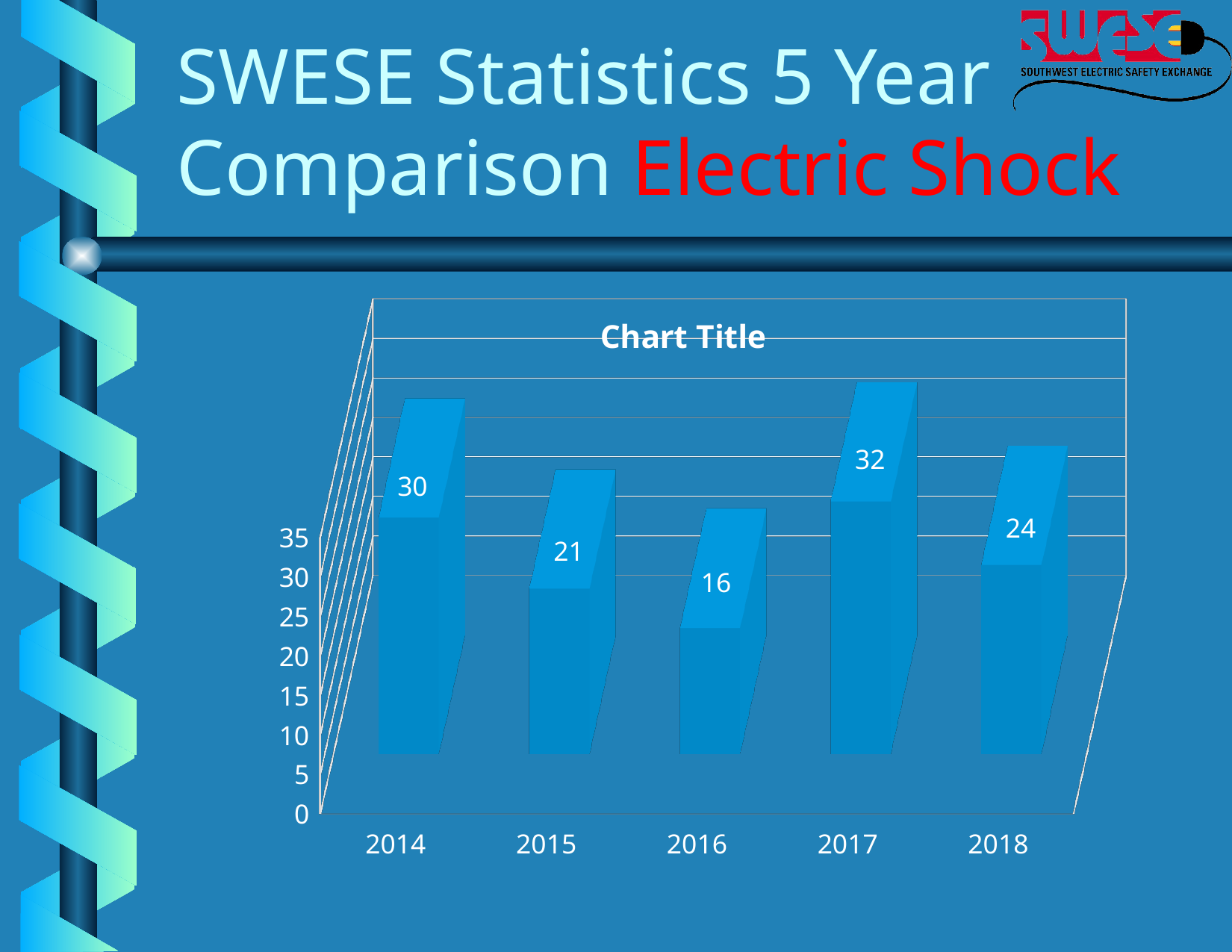
How many years are shown on the x axis? 5 What is the value for 2016? 16 What kind of chart is shown on the slide? bar chart Which year has the lowest value? 2016 What is the title printed on the chart? Chart Title Which year has the highest value? 2017 What is the value for 2014? 30 What is the difference between the values for 2014 and 2015? 9 What is the difference between the values for 2017 and 2016? 16 Is the value for 2017 greater or less than 25? greater What is the value for 2018? 24 Which is larger, the value for 2015 or the value for 2018? 2018